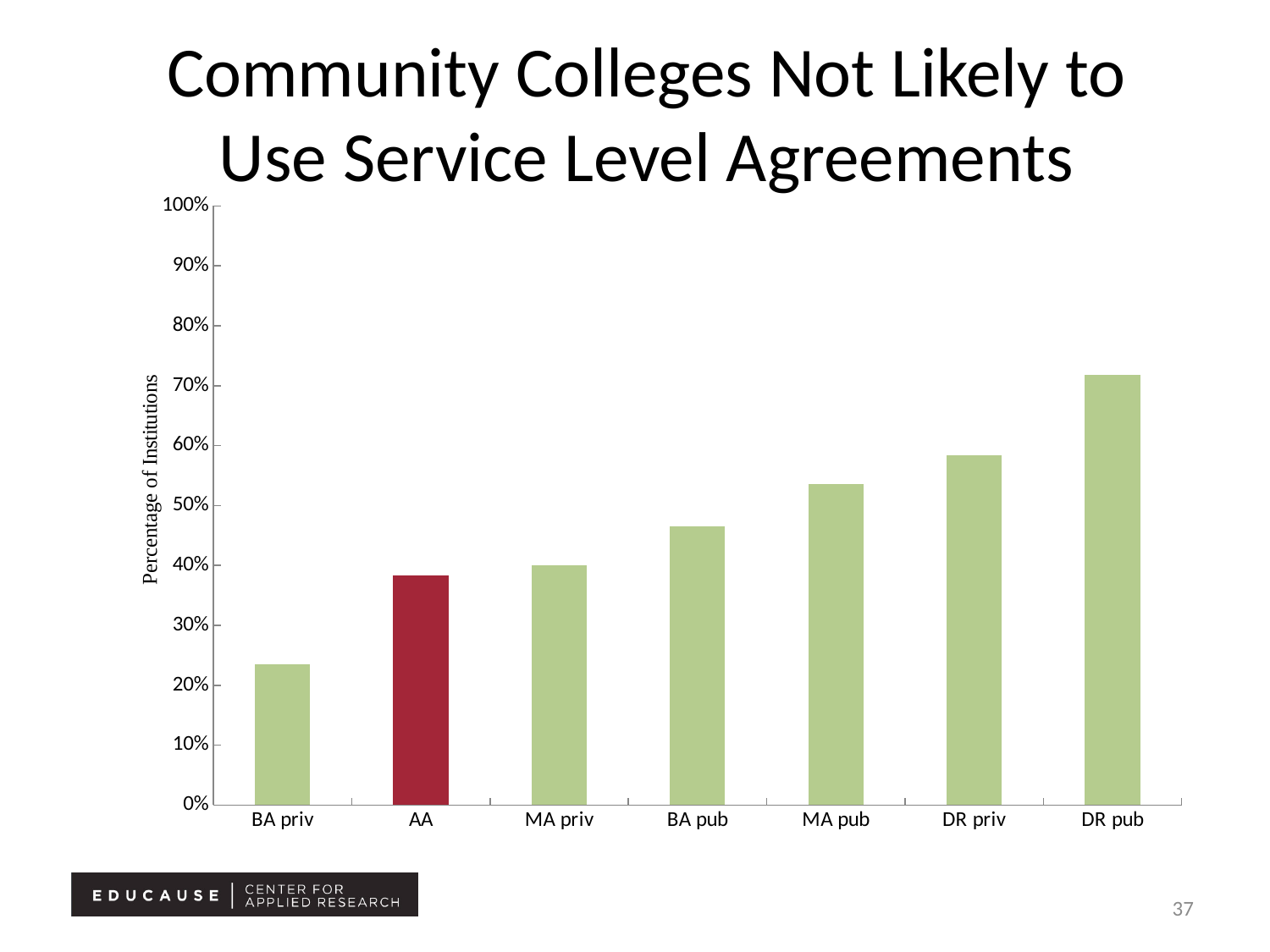
Which category's bar is coloured red rather than green? AA How many categories are plotted on the x axis? 7 Is the value for BA priv greater or less than 30%? less What is the label on the y axis? Percentage of Institutions Is the value for DR pub greater or less than 70%? greater Do the values rise or fall moving from left to right along the x axis? rise What kind of chart is shown on the slide? bar chart Is the value for AA greater or less than 30%? greater Which is larger, the value for DR priv or the value for BA pub? DR priv Which category has the lowest percentage of institutions? BA priv Which category has the highest percentage of institutions? DR pub